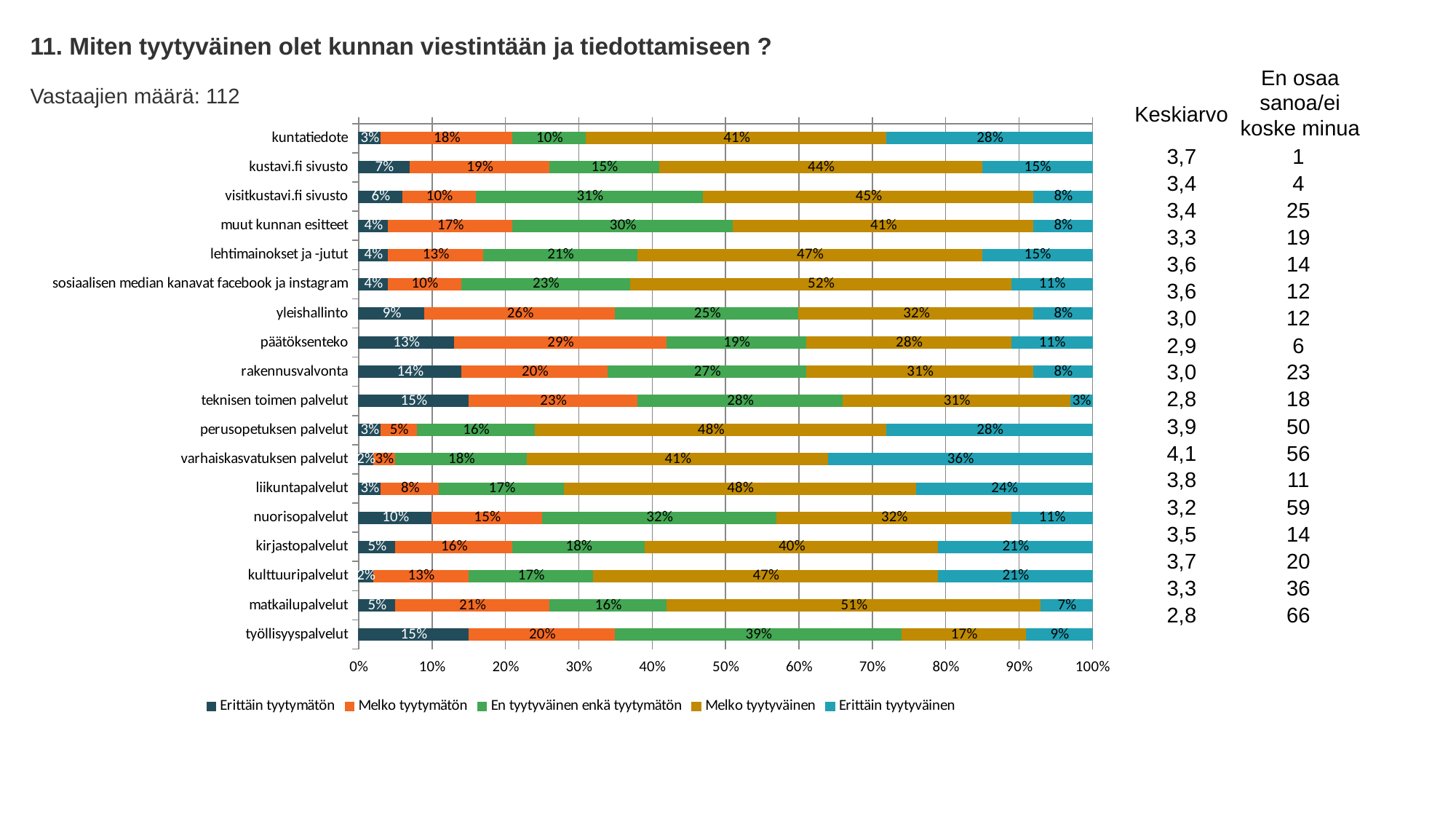
How many categories (rows) does the chart show? 18 Which category has the lowest 'Erittäin tyytyväinen' share? teknisen toimen palvelut What kind of chart is shown on the slide? Stacked bar chart Which category has the highest 'Erittäin tyytyväinen' share? varhaiskasvatuksen palvelut What is the difference between the 'Erittäin tyytyväinen' values for kuntatiedote and kustavi.fi sivusto? 13 percentage points What is the 'Melko tyytyväinen' value for kuntatiedote? 41% What is the 'Melko tyytyväinen' value for sosiaalisen median kanavat facebook ja instagram? 52% Which has the larger 'Melko tyytymätön' value, päätöksenteko or yleishallinto? päätöksenteko Which legend entry is shown in the gold/brown colour? Melko tyytyväinen What is the 'En tyytyväinen enkä tyytymätön' value for työllisyyspalvelut? 39% What is the 'Erittäin tyytyväinen' value for varhaiskasvatuksen palvelut? 36% How many series does the legend list? 5